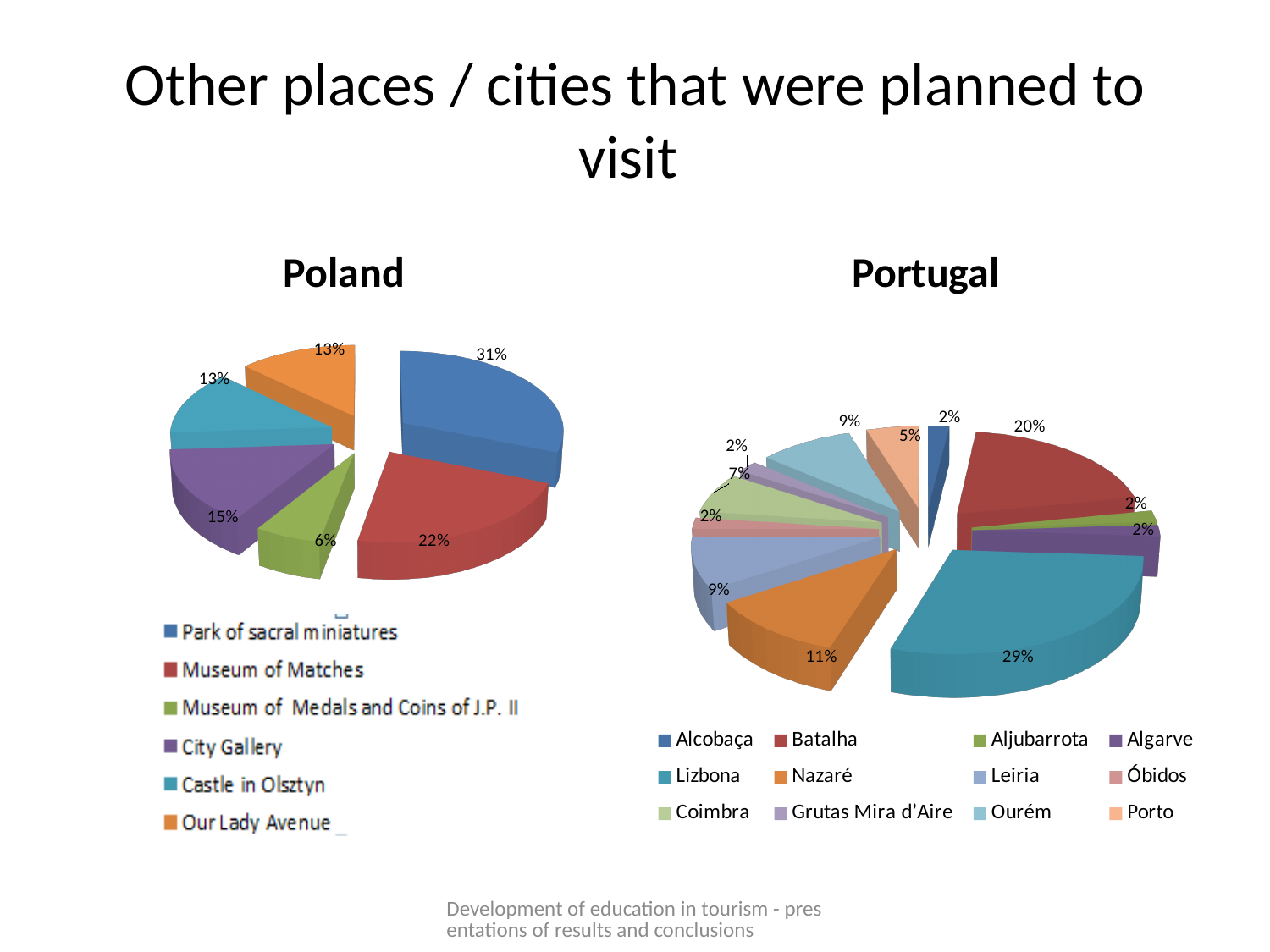
In the Poland chart, which place has the largest share? Park of sacral miniatures What type of chart is the Portugal chart? Pie chart In the Portugal chart, which is larger, the share for Batalha or the share for Coimbra? Batalha How many categories does the Poland chart show? 6 How many categories does the Portugal chart's legend list? 12 In the Poland chart, what is the difference between the shares of Park of sacral miniatures and Museum of Matches? 9% In the Portugal chart, what share does Lizbona have? 29% In the Poland chart, what share does Park of sacral miniatures have? 31% In the Poland chart, what share does City Gallery have? 15% In the Portugal chart, which city has the largest share? Lizbona In the Poland chart, which place has the smallest share? Museum of Medals and Coins of J.P. II In the Portugal chart, what share does Nazaré have? 11%